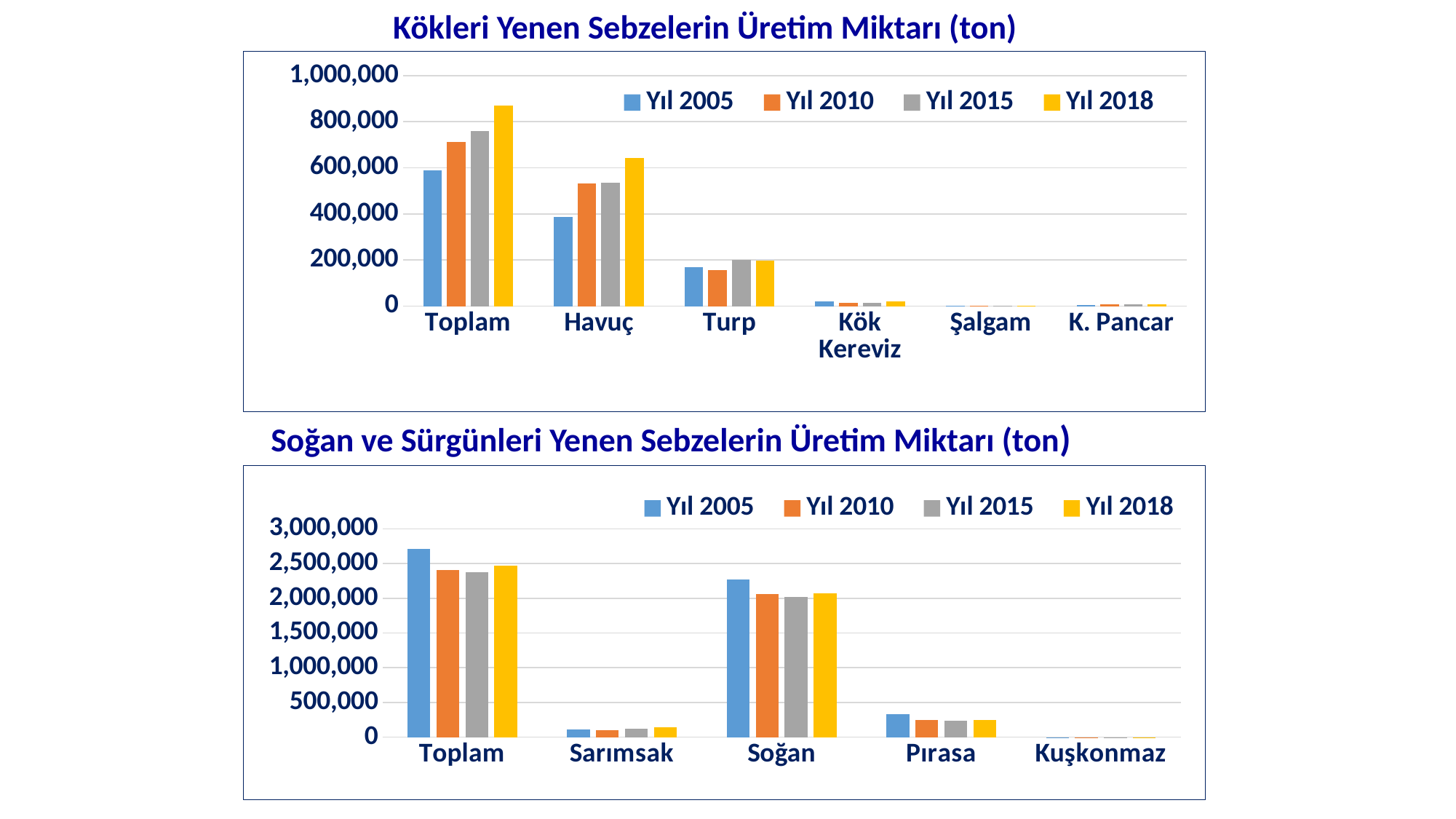
In the top chart (Kökleri Yenen Sebzelerin Üretim Miktarı), how many categories are shown on the x axis? 6 In the top chart (Kökleri Yenen Sebzelerin Üretim Miktarı), which is larger for Yıl 2005: Havuç or Turp? Havuç In the top chart (Kökleri Yenen Sebzelerin Üretim Miktarı), how many series does the legend list? 4 In the bottom chart (Soğan ve Sürgünleri Yenen Sebzelerin Üretim Miktarı), which year has the highest value for Toplam? Yıl 2005 In the top chart (Kökleri Yenen Sebzelerin Üretim Miktarı), is the Yıl 2018 value for Havuç greater or less than 600,000? greater In the top chart (Kökleri Yenen Sebzelerin Üretim Miktarı), do the Toplam values rise or fall from Yıl 2005 to Yıl 2018? rise In the top chart (Kökleri Yenen Sebzelerin Üretim Miktarı), is the Yıl 2018 value for Toplam greater or less than 800,000? greater What type of chart is the bottom chart (Soğan ve Sürgünleri Yenen Sebzelerin Üretim Miktarı)? bar chart In the bottom chart (Soğan ve Sürgünleri Yenen Sebzelerin Üretim Miktarı), how many categories are shown on the x axis? 5 In the bottom chart (Soğan ve Sürgünleri Yenen Sebzelerin Üretim Miktarı), is the Yıl 2005 value for Toplam greater or less than 2,500,000? greater In the top chart (Kökleri Yenen Sebzelerin Üretim Miktarı), which year has the highest value for Havuç? Yıl 2018